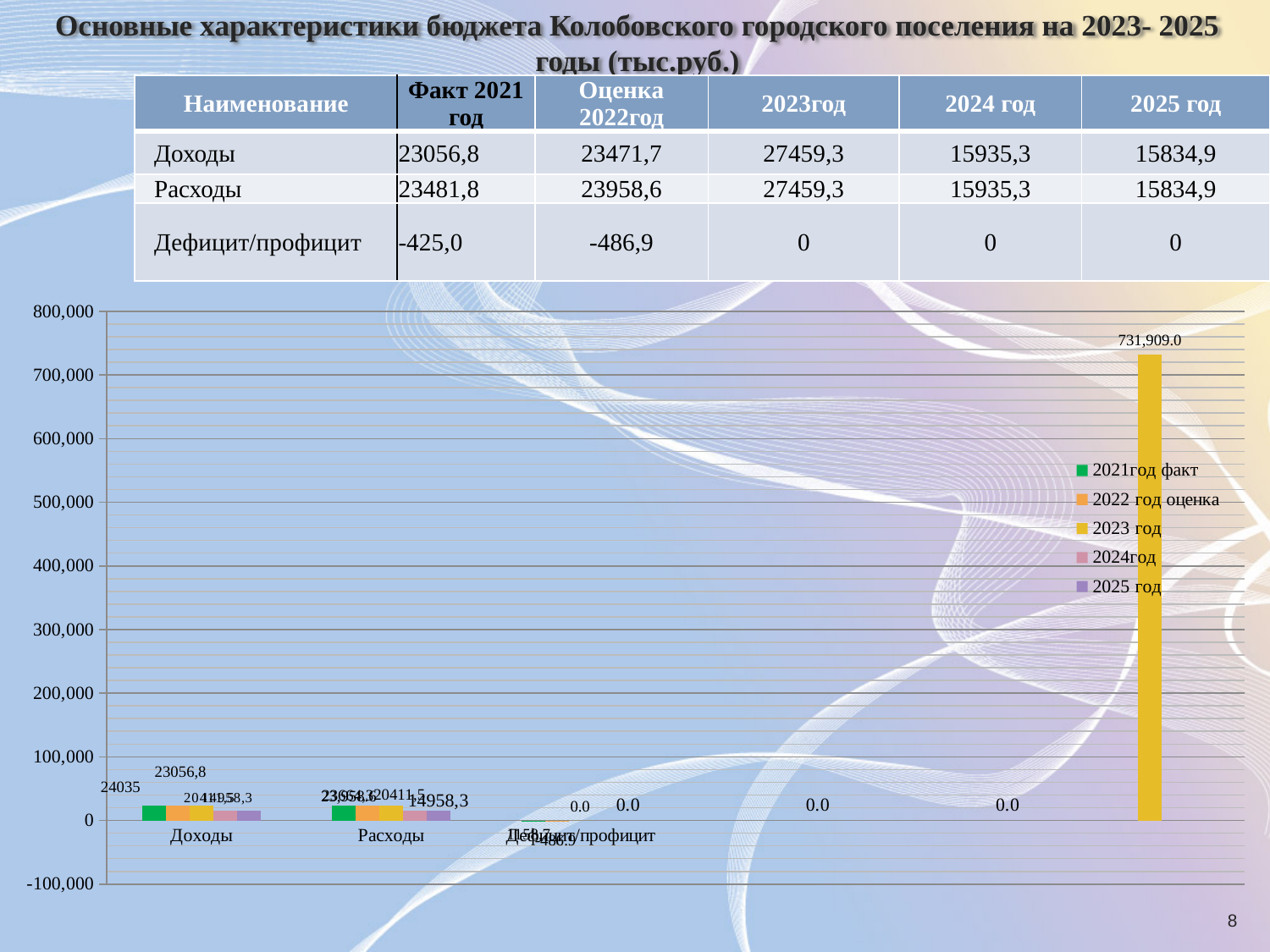
Is the value of the tallest bar in the chart greater or less than 700,000? greater What is the value printed on the tallest bar in the chart? 731,909.0 What kind of chart is shown on the slide? bar chart What is the highest value shown on the chart's vertical axis? 800,000 Which is larger: the 2021год факт bar for Доходы or the bar labelled 731,909.0? the bar labelled 731,909.0 What is the lowest value shown on the chart's vertical axis? -100,000 How many series does the chart legend list? 5 Is the value of the 2021год факт bar for Доходы greater or less than 100,000? less Which series (by legend entry) does the tallest bar in the chart belong to? 2023 год